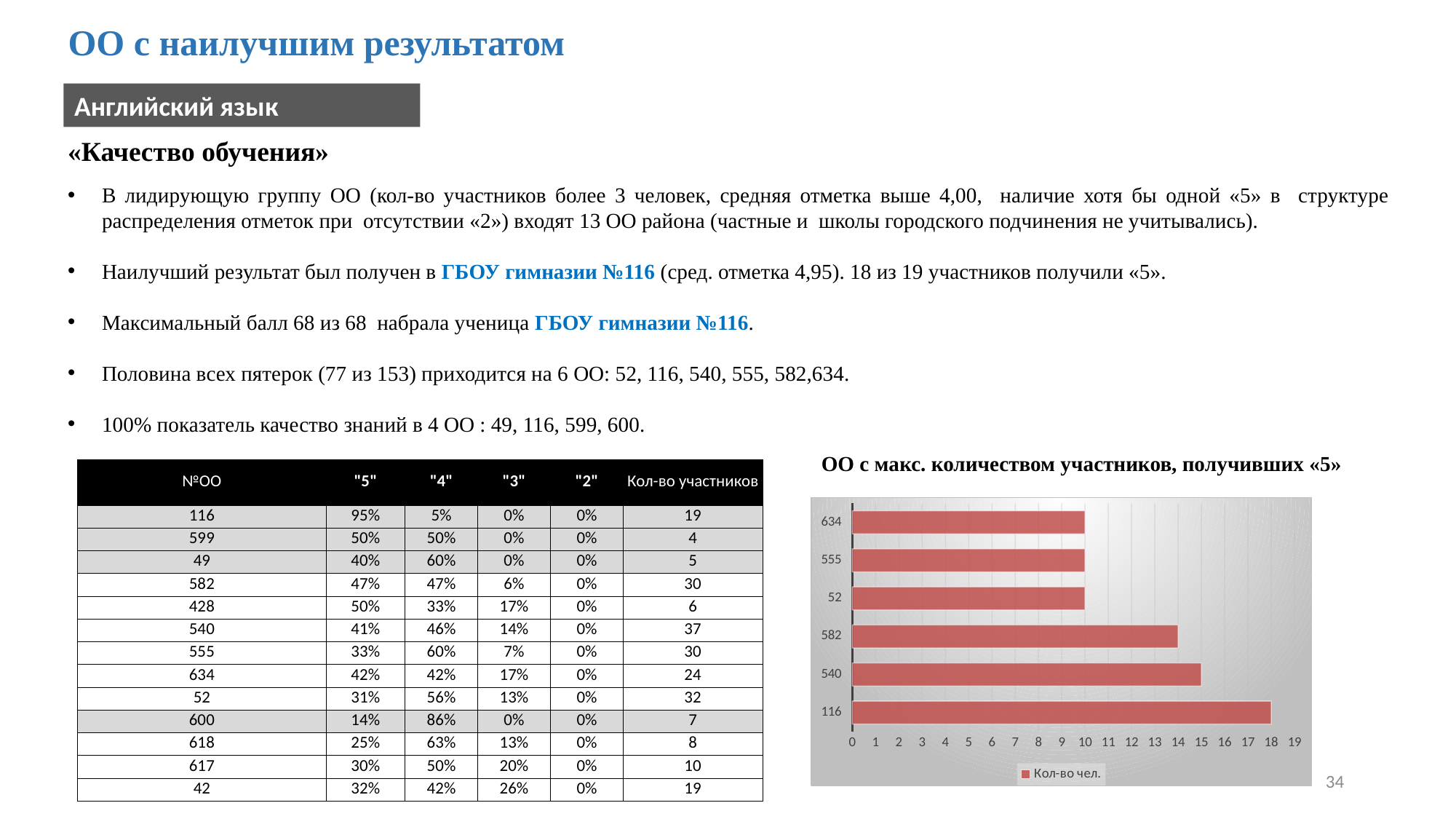
Which category has the longest bar in the chart «ОО с макс. количеством участников, получивших «5»»? 116 In the bar chart, is the value for 540 greater or less than 10? greater How many categories (ОО numbers) are plotted in the chart «ОО с макс. количеством участников, получивших «5»»? 6 In the bar chart, is the value for 555 greater or less than 15? less In the bar chart, which has the larger value: 116 or 634? 116 In the bar chart, what is the value for category 116? 18 In the bar chart, is the value for 634 greater or less than 15? less What is the legend entry of the bar chart? Кол-во чел. How many series does the legend of the bar chart list? 1 What kind of chart is shown on the right side of the slide? bar chart In the bar chart, which has the larger value: 540 or 52? 540